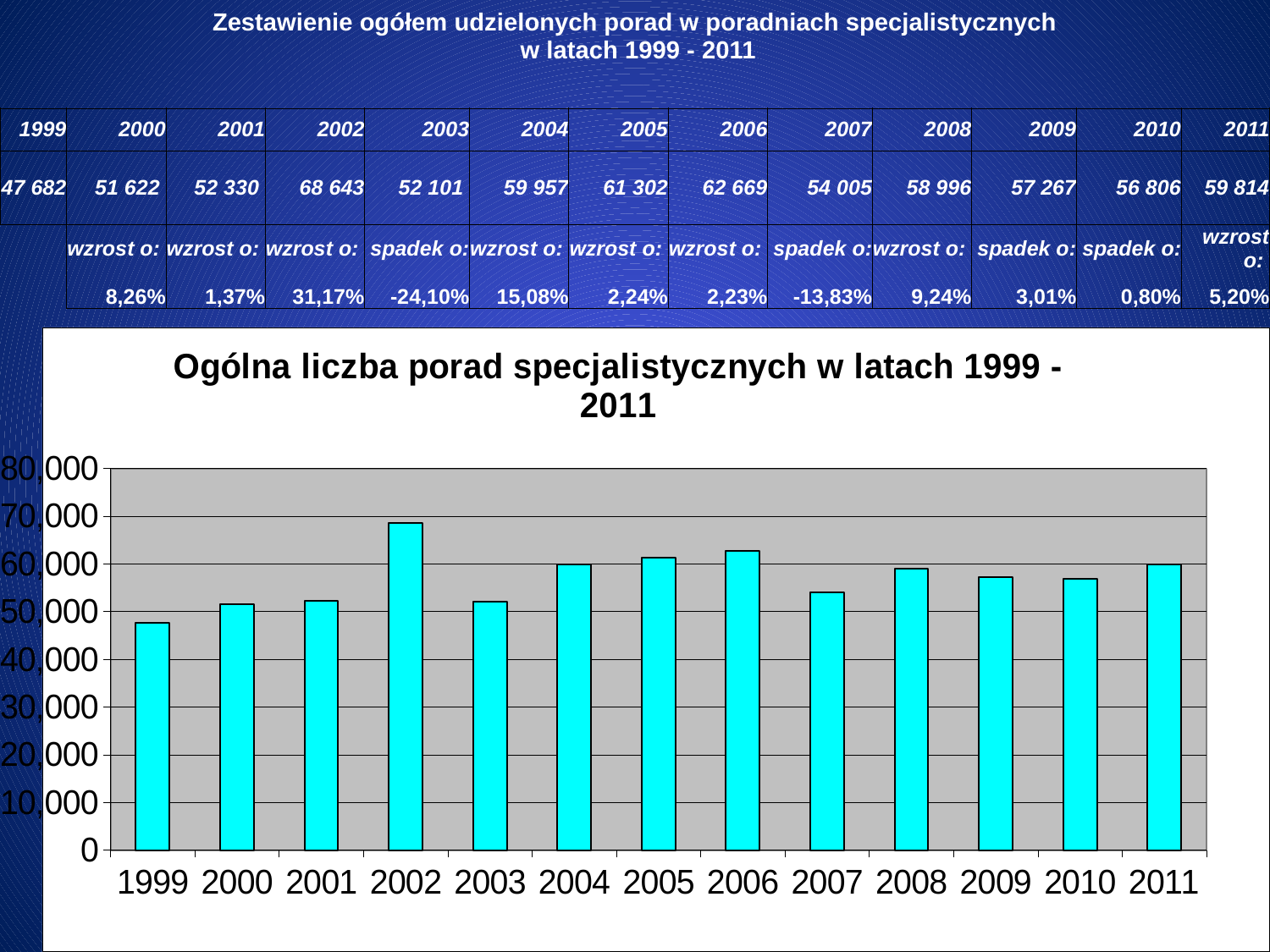
Which year has the highest number of specialist consultations in the chart? 2002 What kind of chart is shown on the slide? bar chart How many years are plotted on the x axis of the chart? 13 Is the value for 2002 in the chart greater or less than 60,000? greater According to the table, what is the number of consultations in 2007? 54 005 Is the value for 1999 in the chart greater or less than 50,000? less Which year has the larger value in the chart, 2006 or 2007? 2006 According to the table, what is the number of consultations in 2002? 68 643 Using the table values, what is the difference between the number of consultations in 2002 and in 1999? 20 961 Which year has the lowest number of specialist consultations in the chart? 1999 According to the table, what is the percentage change shown for 2002? 31,17% Between 2002 and 2003, does the value in the chart rise or fall? fall